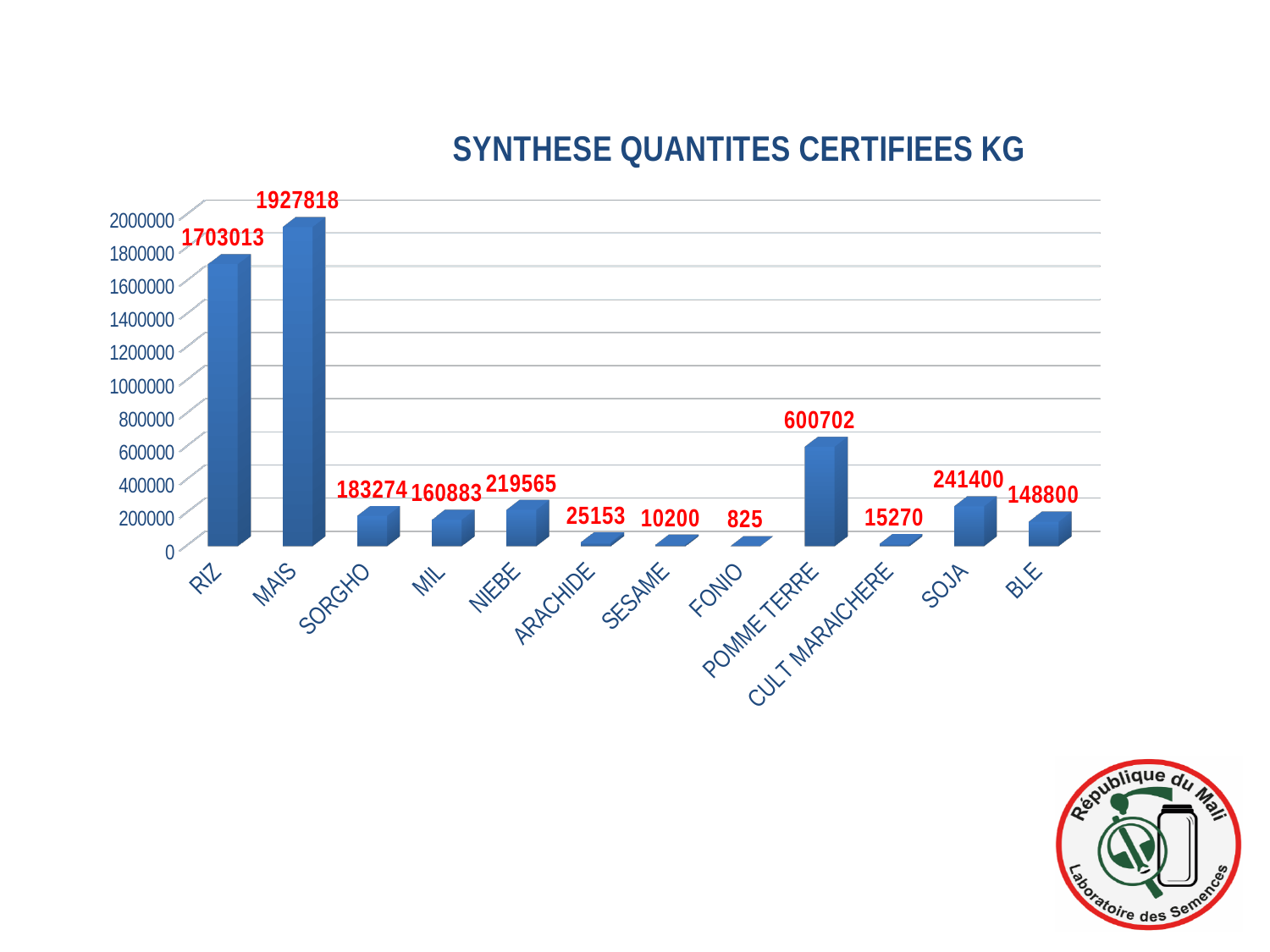
What is the certified quantity for MAIS? 1927818 What kind of chart is shown on the slide? Bar chart Which category has the lowest certified quantity? FONIO What is the difference between the certified quantities for SOJA and BLE? 92600 What is the certified quantity for POMME TERRE? 600702 What is the certified quantity for FONIO? 825 How many categories are shown on the x axis? 12 What is the difference between the certified quantities for MAIS and RIZ? 224805 What is the title of the chart? SYNTHESE QUANTITES CERTIFIEES KG Which category has the highest certified quantity? MAIS Which has a larger certified quantity, SOJA or NIEBE? SOJA Which has a larger certified quantity, SORGHO or MIL? SORGHO